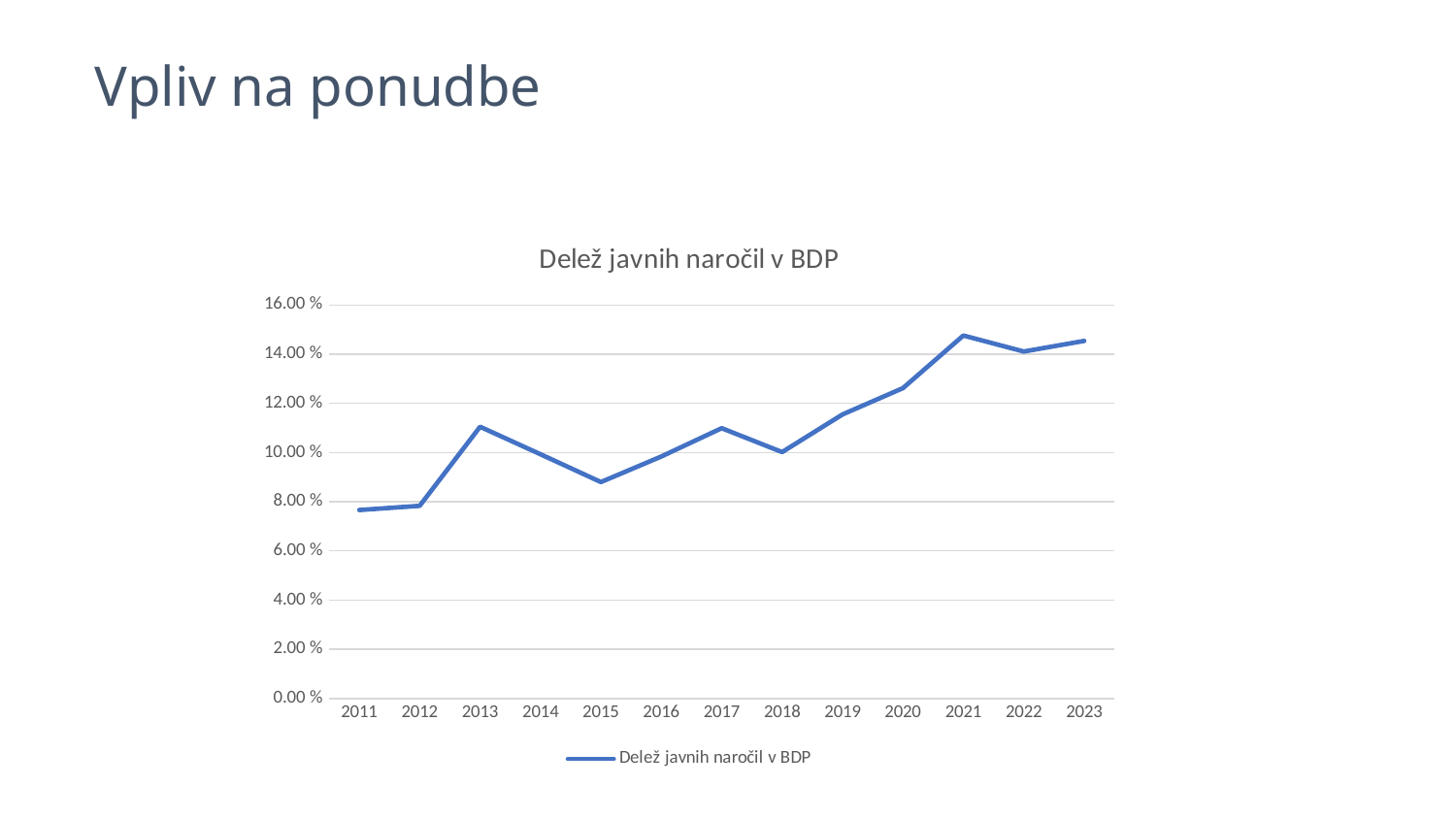
Do the values generally rise or fall from 2011 to 2023? rise How many series does the legend list? 1 Which year has the larger value, 2013 or 2015? 2013 What is the title of the chart? Delež javnih naročil v BDP What kind of chart is shown on the slide? line chart Which year has the larger value, 2017 or 2020? 2020 How many years are plotted along the x axis? 13 Is the value for 2011 greater or less than 8.00 %? less Is the value for 2015 greater or less than 10.00 %? less Is the value for 2013 greater or less than 10.00 %? greater